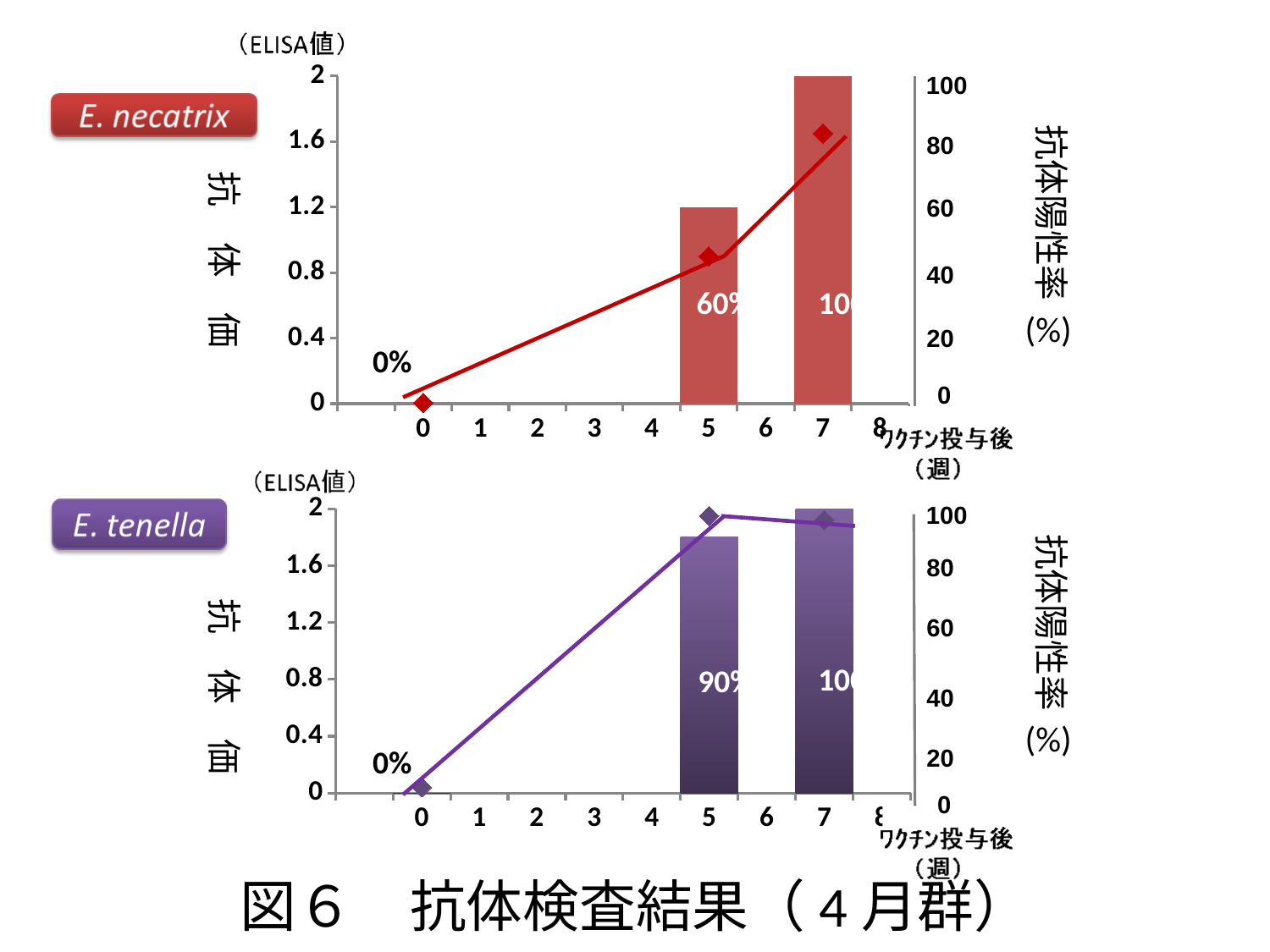
In the E. necatrix chart, what is the antibody positive rate (抗体陽性率) at week 5 after vaccination? 60% In the E. necatrix chart, is the antibody titer (ELISA value) line point at week 7 greater or less than 1.2? greater In the E. tenella chart, what does the right-hand vertical axis represent? 抗体陽性率 (%) In the E. tenella chart, what is the antibody positive rate at week 7 after vaccination? 100% In the E. tenella chart, at how many time points (weeks) are data plotted? 3 In the E. necatrix chart, does the antibody titer line rise or fall from week 0 to week 7? Rises In the E. necatrix chart, by how many percentage points does the antibody positive rate at week 7 exceed that at week 5? 40% In the E. necatrix chart, what is the antibody positive rate at week 0? 0% At week 5, which chart shows the higher antibody positive rate, E. necatrix or E. tenella? E. tenella What kind of chart is the E. necatrix chart? Combined bar and line chart In the E. tenella chart, what is the antibody positive rate at week 5 after vaccination? 90% In the E. tenella chart, is the antibody titer (ELISA value) line point at week 5 greater or less than 1.6? greater